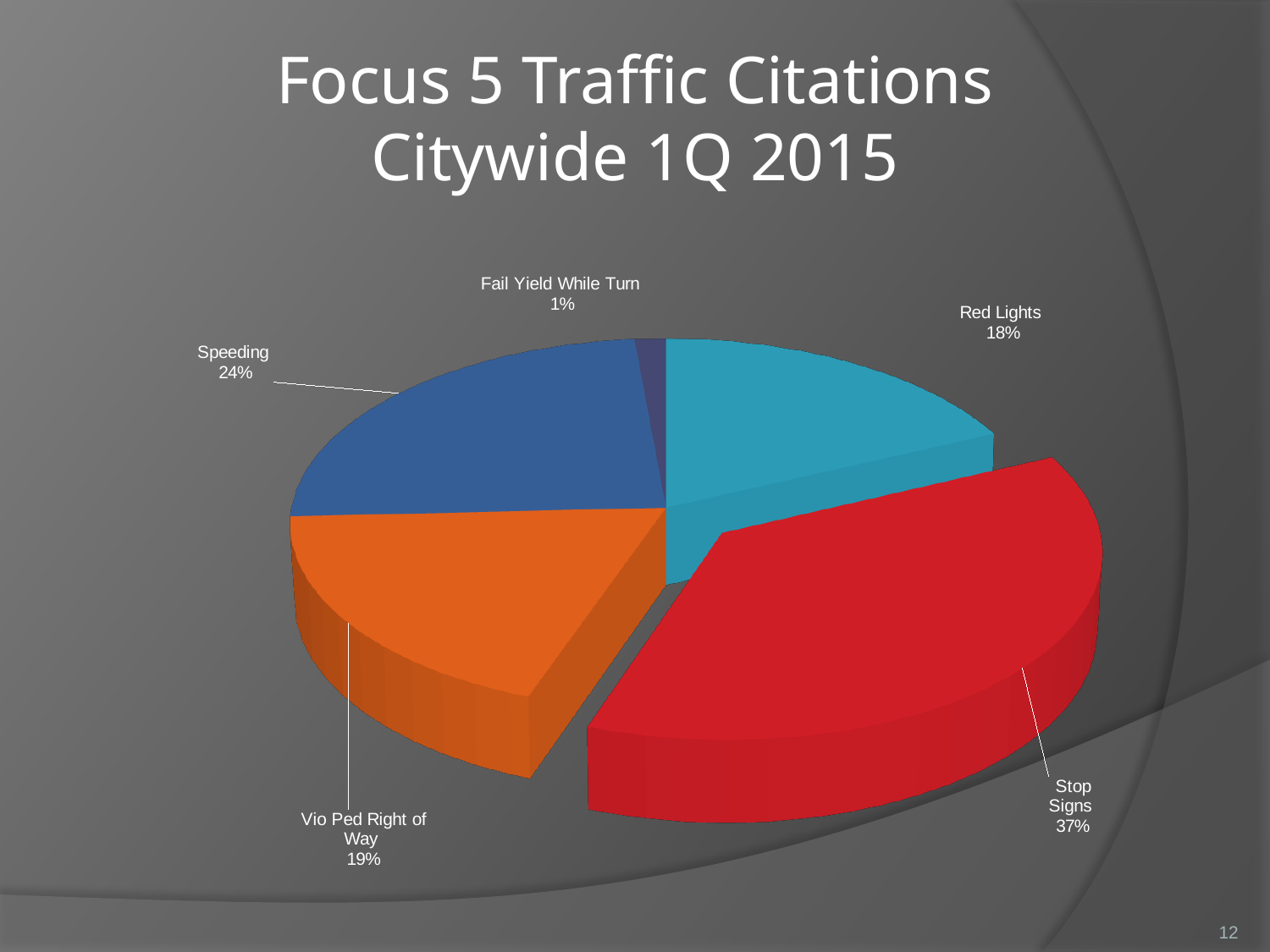
What colour is the Stop Signs slice? Red Which category has the smallest slice of the pie? Fail Yield While Turn What percentage is shown for Speeding? 24% What is the title of the slide containing the chart? Focus 5 Traffic Citations Citywide 1Q 2015 What is the difference in percentage points between Stop Signs and Speeding? 13 What share of the pie does Stop Signs represent? 37% Which category has the largest slice of the pie? Stop Signs What kind of chart is shown on the slide? Pie chart Which is larger, the share for Speeding or the share for Red Lights? Speeding How many categories are shown in the pie chart? 5 What percentage is shown for Vio Ped Right of Way? 19% What percentage is shown for Red Lights? 18%